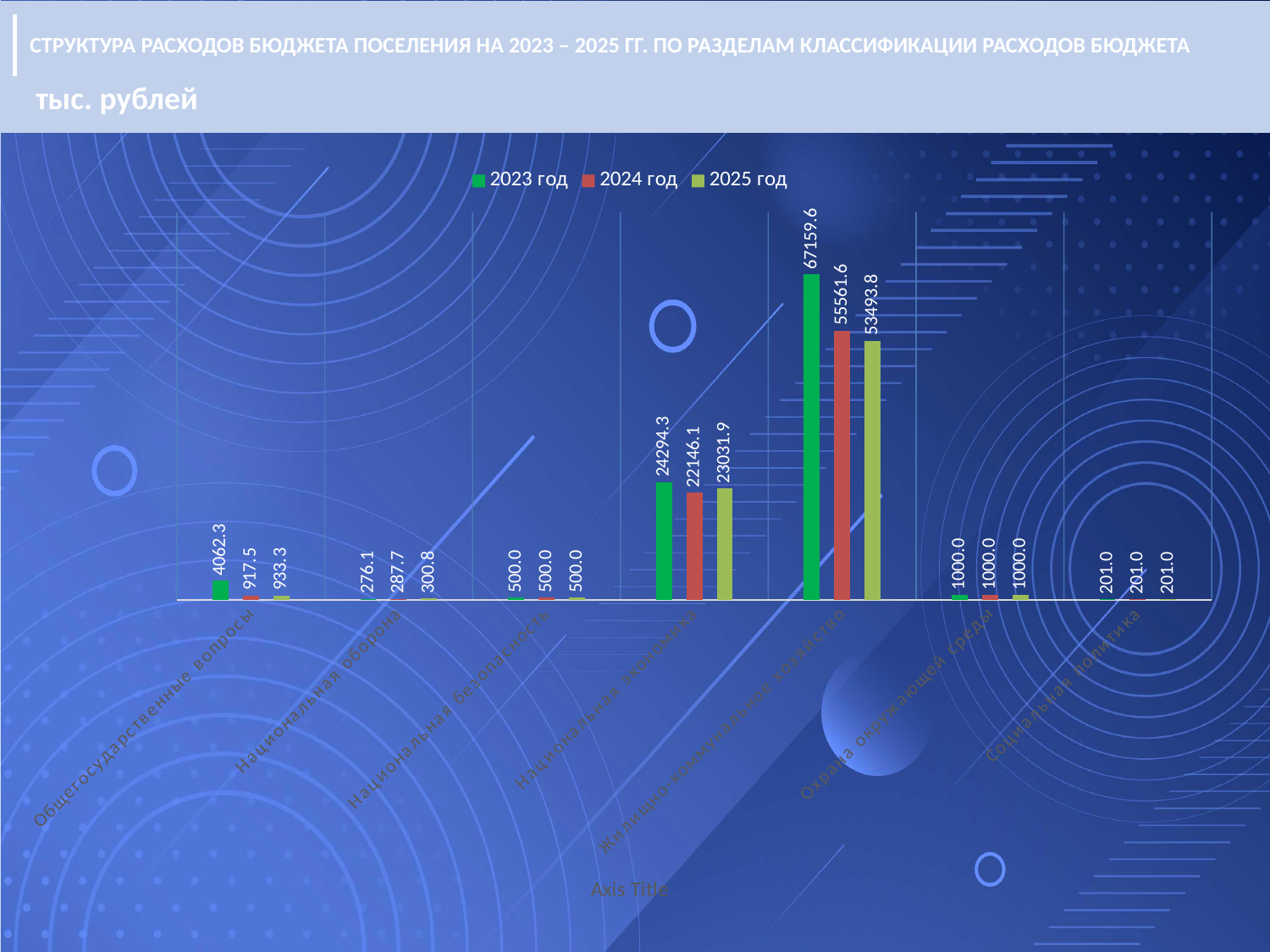
What is the value for Общегосударственные вопросы in the 2024 год series? 917.5 What unit is stated above the chart? тыс. рублей Which category has the highest value in the 2024 год series? Жилищно-коммунальное хозяйство How many categories are shown on the x axis? 7 What is the difference between the 2023 год and 2025 год values for Жилищно-коммунальное хозяйство? 13665.8 How many series does the legend list? 3 Do the values for Национальная оборона rise or fall from 2023 год to 2025 год? rise Which category has the lowest value in the 2023 год series? Социальная политика Which is larger for Национальная экономика: the 2024 год value or the 2025 год value? 2025 год What kind of chart is shown on the slide? bar chart What is the value for Национальная экономика in the 2025 год series? 23031.9 What is the value for Жилищно-коммунальное хозяйство in the 2023 год series? 67159.6